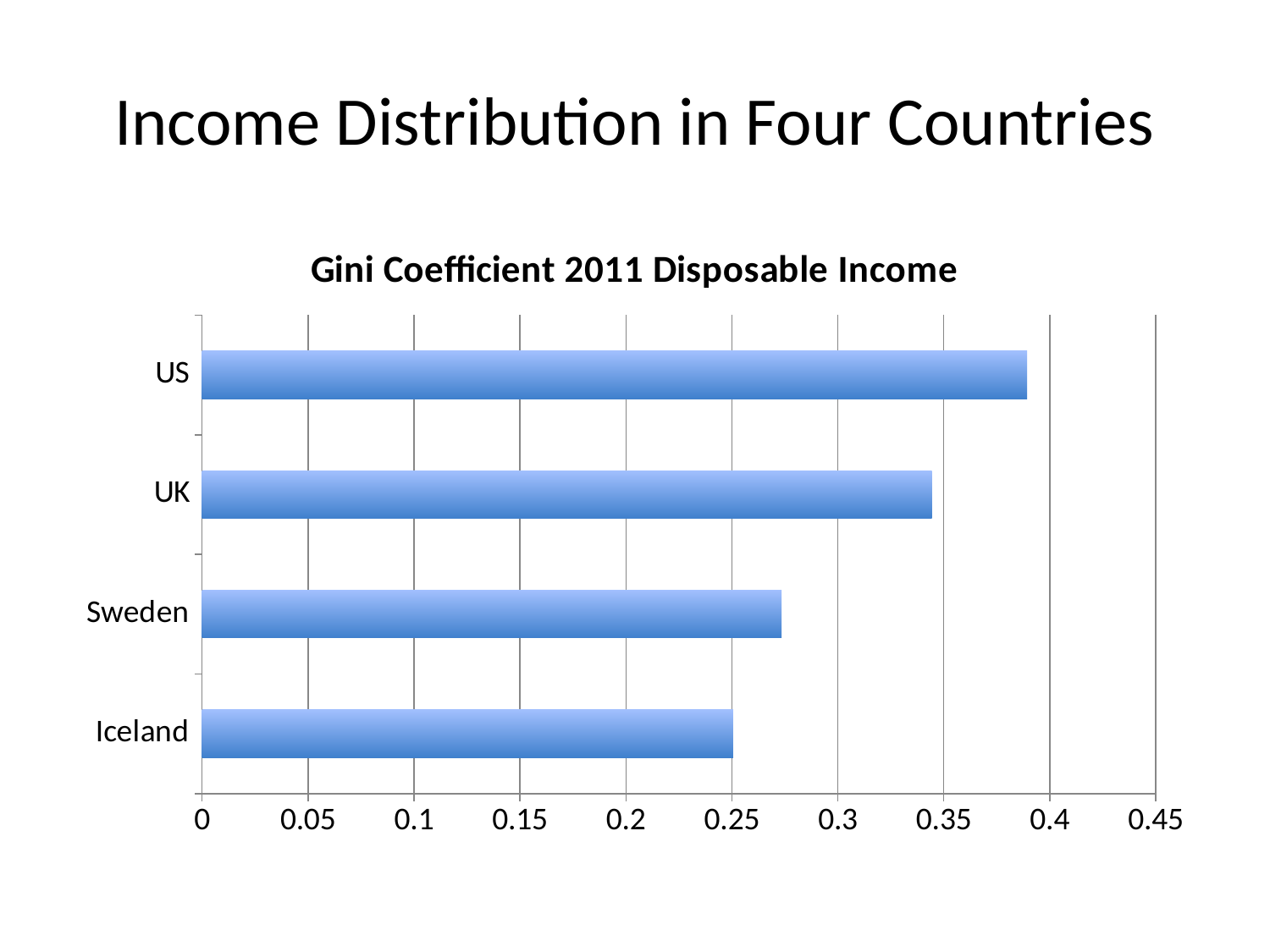
What type of chart is shown on the slide? bar chart Is the value for Sweden greater or less than 0.3? less Which country has the lowest Gini coefficient? Iceland Is the value for the UK greater or less than 0.3? greater Is the value for the UK greater or less than 0.35? less Which has a larger Gini coefficient, Iceland or the US? US Which has a larger Gini coefficient, the UK or Sweden? UK What is the maximum value shown on the horizontal axis? 0.45 Which country has the highest Gini coefficient? US What is the title of the chart? Gini Coefficient 2011 Disposable Income How many countries are shown in the chart? 4